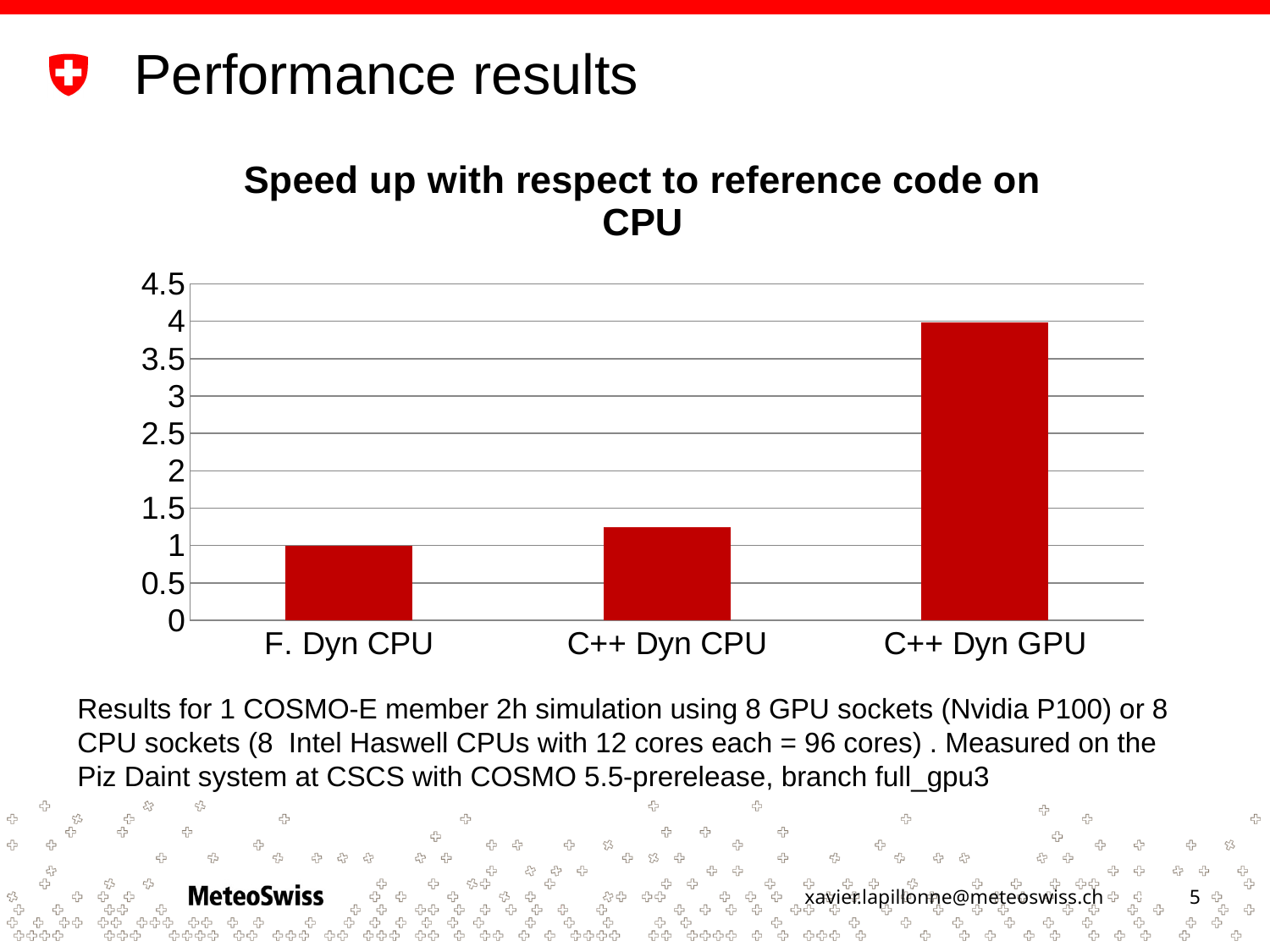
Which category has the lowest speed up? F. Dyn CPU Do the bar values rise or fall from left to right along the x axis? rise Is the speed up for C++ Dyn GPU greater or less than 3.5? greater Is the speed up for C++ Dyn CPU greater or less than 1.5? less How many categories are shown on the x axis of the chart? 3 Is the speed up for C++ Dyn GPU greater or less than 4.5? less Which has a larger speed up, C++ Dyn CPU or C++ Dyn GPU? C++ Dyn GPU What is the title of the chart? Speed up with respect to reference code on CPU What kind of chart is shown on the slide? bar chart Which has a larger speed up, F. Dyn CPU or C++ Dyn CPU? C++ Dyn CPU Which category has the highest speed up? C++ Dyn GPU